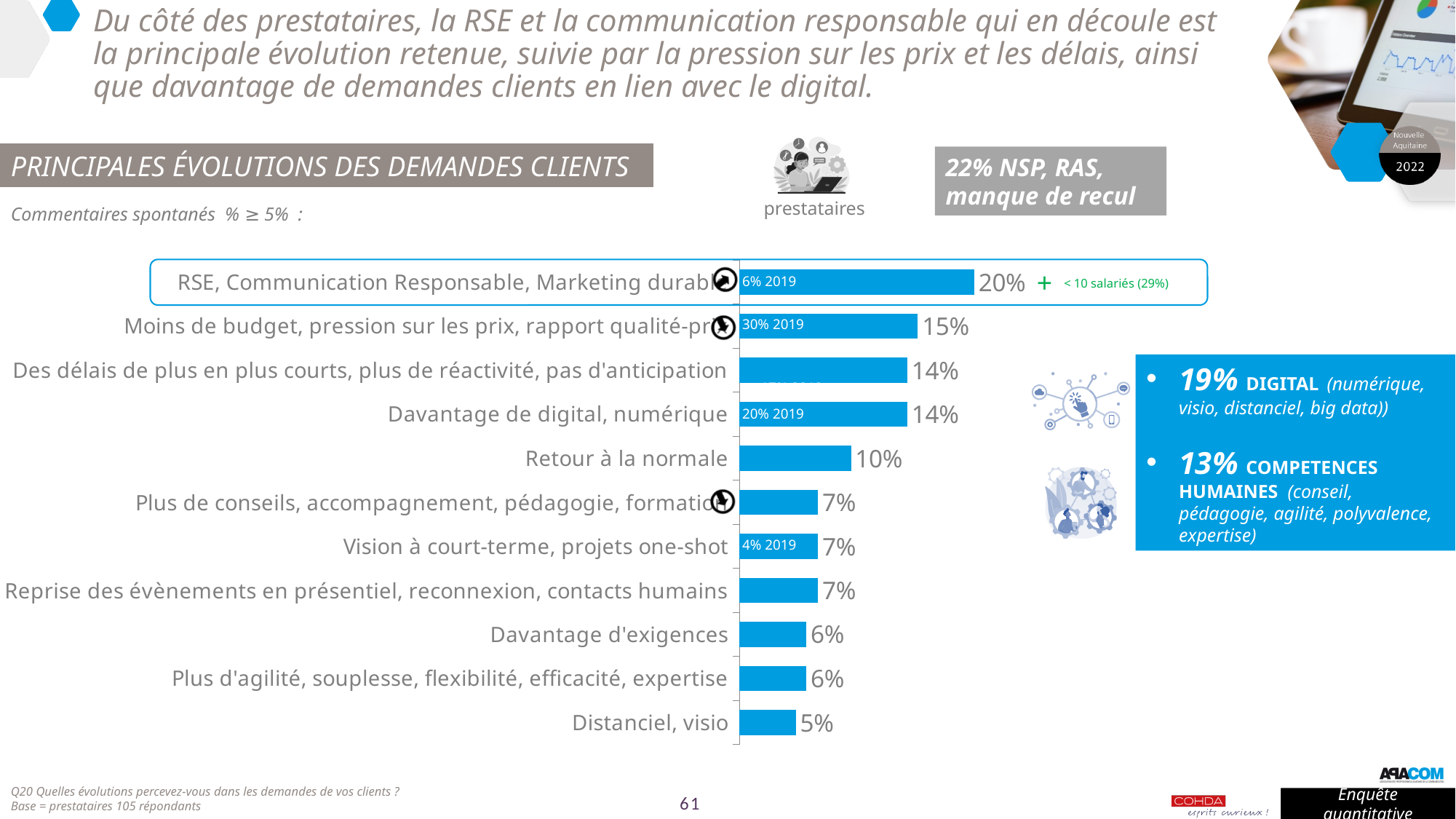
What is the title of the chart section on the slide? PRINCIPALES ÉVOLUTIONS DES DEMANDES CLIENTS What is the value for "Davantage de digital, numérique"? 14% What is the value for "RSE, Communication Responsable, Marketing durable"? 20% How many categories are plotted in the bar chart? 11 Which category has the highest value in the chart? RSE, Communication Responsable, Marketing durable What is the value for "Retour à la normale"? 10% Which is larger: the value for "Retour à la normale" or the value for "Davantage d'exigences"? Retour à la normale What was the 2019 value shown for "Moins de budget, pression sur les prix, rapport qualité-prix"? 30% Which category has the lowest value in the chart? Distanciel, visio What kind of chart is shown on the slide? bar chart What is the difference between the value for "RSE, Communication Responsable, Marketing durable" and the value for "Moins de budget, pression sur les prix, rapport qualité-prix"? 5% What is the value for "Distanciel, visio"? 5%